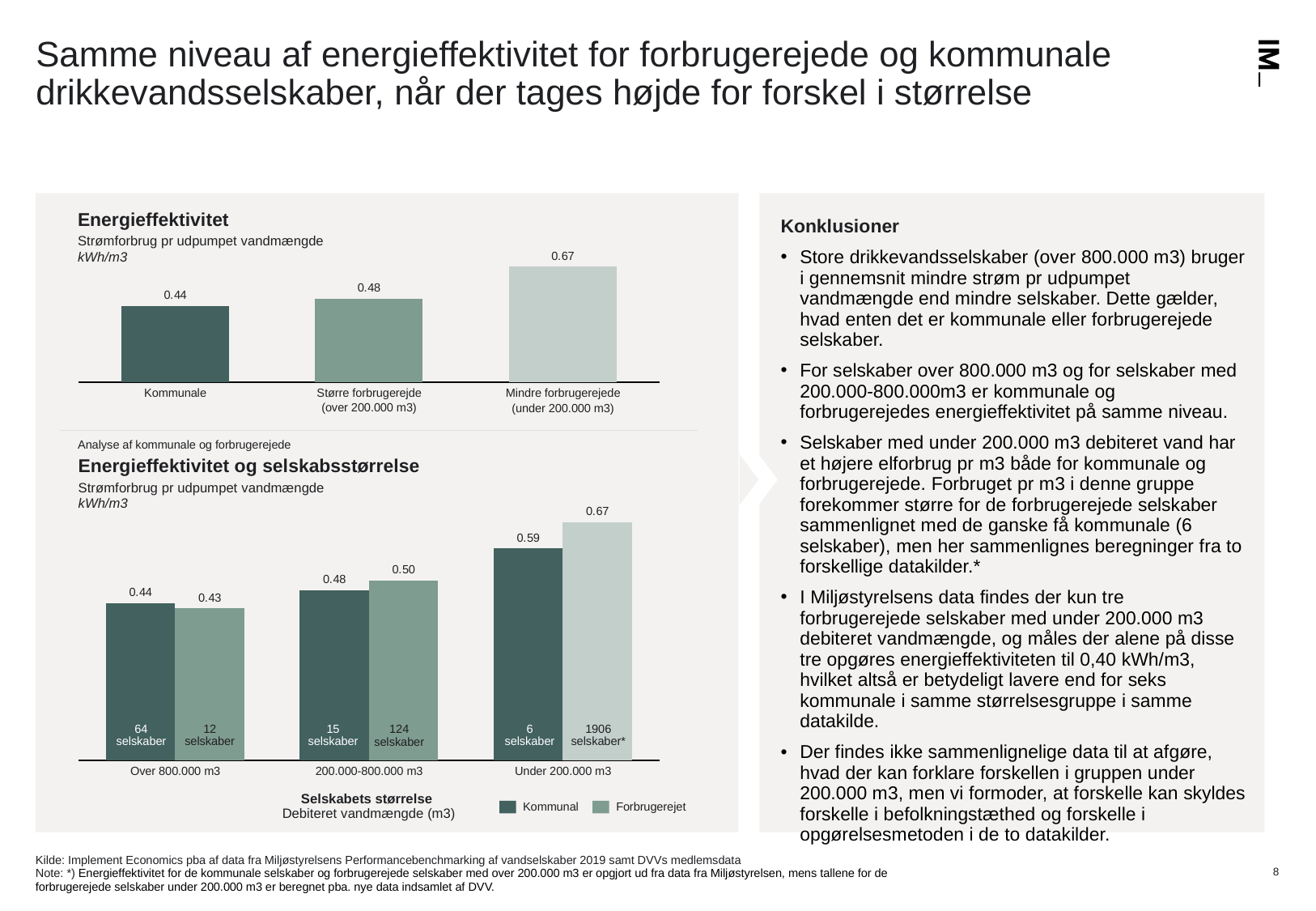
In the 'Energieffektivitet og selskabsstørrelse' chart, do the Kommunal values rise or fall from Over 800.000 m3 to Under 200.000 m3? rise In the 'Energieffektivitet' chart, what is the value for Kommunale? 0.44 In the 'Energieffektivitet og selskabsstørrelse' chart, what is the difference between Forbrugerejet and Kommunal for Under 200.000 m3? 0.08 In the 'Energieffektivitet og selskabsstørrelse' chart, which is larger for Under 200.000 m3: Kommunal or Forbrugerejet? Forbrugerejet What kind of chart is the 'Energieffektivitet og selskabsstørrelse' chart? bar chart In the 'Energieffektivitet og selskabsstørrelse' chart, how many series does the legend list? 2 In the 'Energieffektivitet og selskabsstørrelse' chart, what is the Forbrugerejet value for 200.000-800.000 m3? 0.50 In the 'Energieffektivitet' chart, what is the difference between Mindre forbrugerejede and Kommunale? 0.23 In the 'Energieffektivitet' chart, how many categories are shown? 3 In the 'Energieffektivitet' chart, which category has the highest value? Mindre forbrugerejede (under 200.000 m3) In the 'Energieffektivitet' chart, what is the value for Mindre forbrugerejede (under 200.000 m3)? 0.67 In the 'Energieffektivitet og selskabsstørrelse' chart, what is the Kommunal value for Under 200.000 m3? 0.59